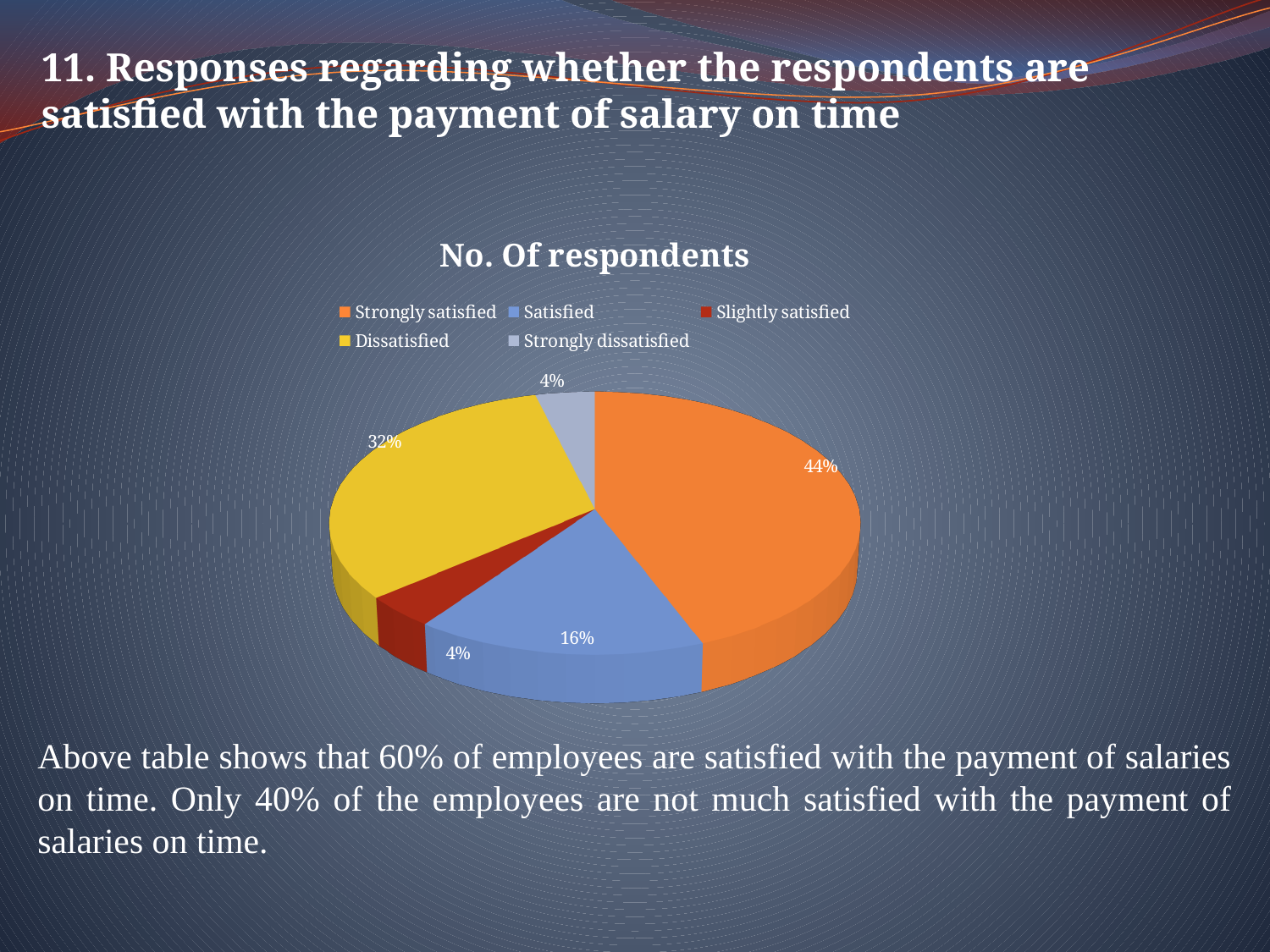
What percentage of respondents are Dissatisfied? 32% What is the title of the chart? No. Of respondents What percentage of respondents are Satisfied? 16% What percentage of respondents are Strongly satisfied? 44% Which colour represents the Dissatisfied category in the pie chart? yellow What percentage of respondents are Slightly satisfied? 4% What kind of chart is shown on the slide? pie chart How many categories does the legend list? 5 What percentage of respondents are Strongly dissatisfied? 4% Which is larger, the share for Dissatisfied or the share for Satisfied? Dissatisfied What is the difference in percentage points between the Strongly satisfied share and the Dissatisfied share? 12 Which category has the largest share of the pie? Strongly satisfied